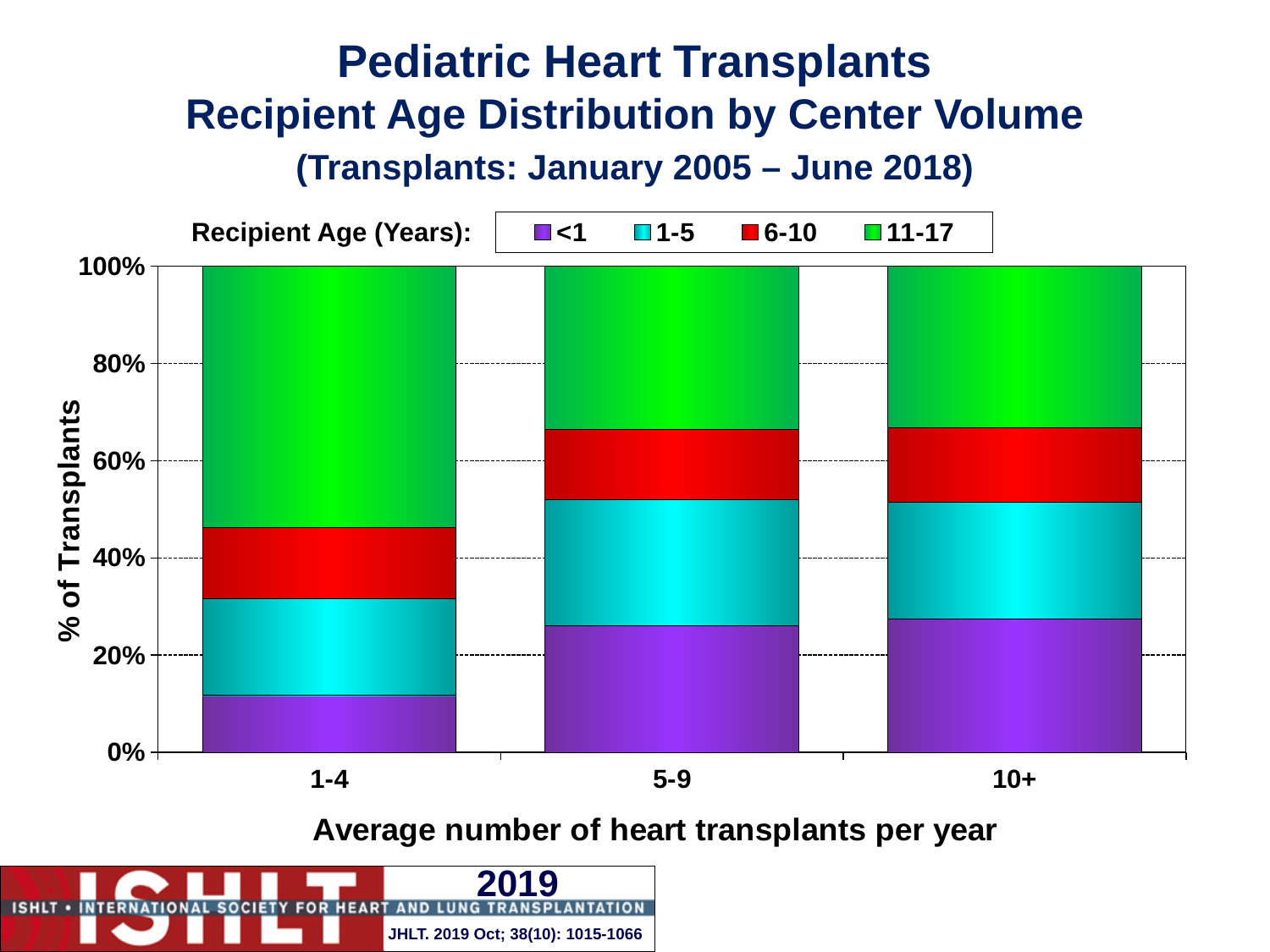
What kind of chart is shown on the slide? Stacked bar chart Which center volume category has the smallest share of recipients aged <1 year? 1-4 Is the share of recipients aged 11-17 years in the 1-4 category greater or less than 40%? greater Is the share of recipients aged <1 year larger in the 1-4 category or the 5-9 category? 5-9 Which center volume category has the largest share of recipients aged 11-17 years? 1-4 How many recipient age groups does the legend list? 4 What is the title of the x axis? Average number of heart transplants per year Which colour represents the 6-10 year recipient age group in the legend? Red Is the share of recipients aged <1 year in the 5-9 category greater or less than 20%? greater Is the share of recipients aged <1 year in the 1-4 category greater or less than 20%? less How many center volume categories are shown on the x axis? 3 What is the total height of the stacked bar for the 5-9 center volume category? 100%